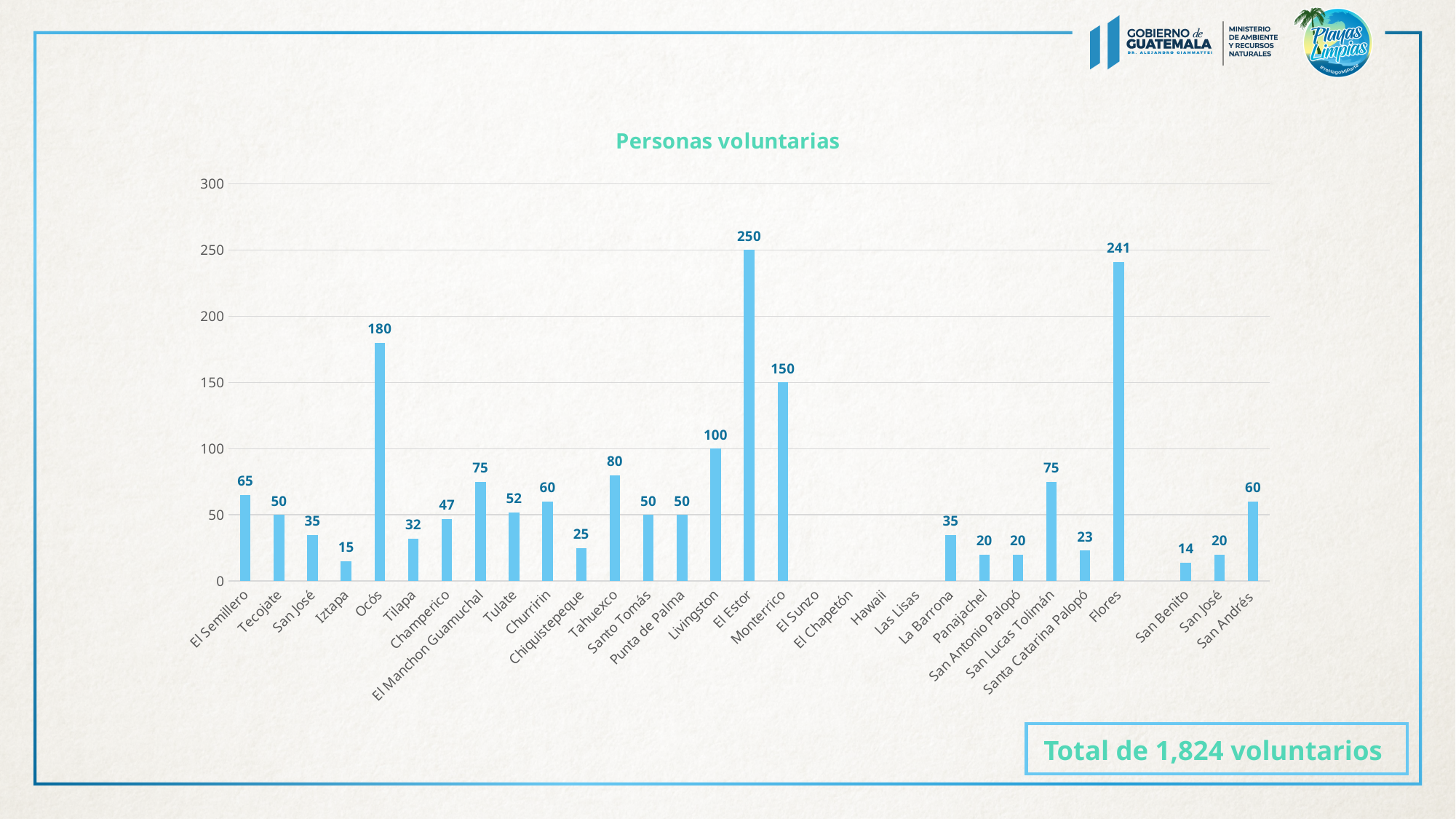
What is the value for Santa Catarina Palopó? 23 What is the title of the chart? Personas voluntarias What total number of volunteers is stated in the box at the bottom right of the slide? 1,824 What is the difference between the values for El Estor and Flores? 9 What is the difference between the values for Ocós and Monterrico? 30 What is the value for Champerico? 47 Is the value for Flores greater or less than 200? greater What kind of chart is shown on the slide? bar chart Which category has the highest value? El Estor What is the value for Ocós? 180 Which is larger, the value for Tahuexco or the value for Livingston? Livingston What is the value for El Estor? 250